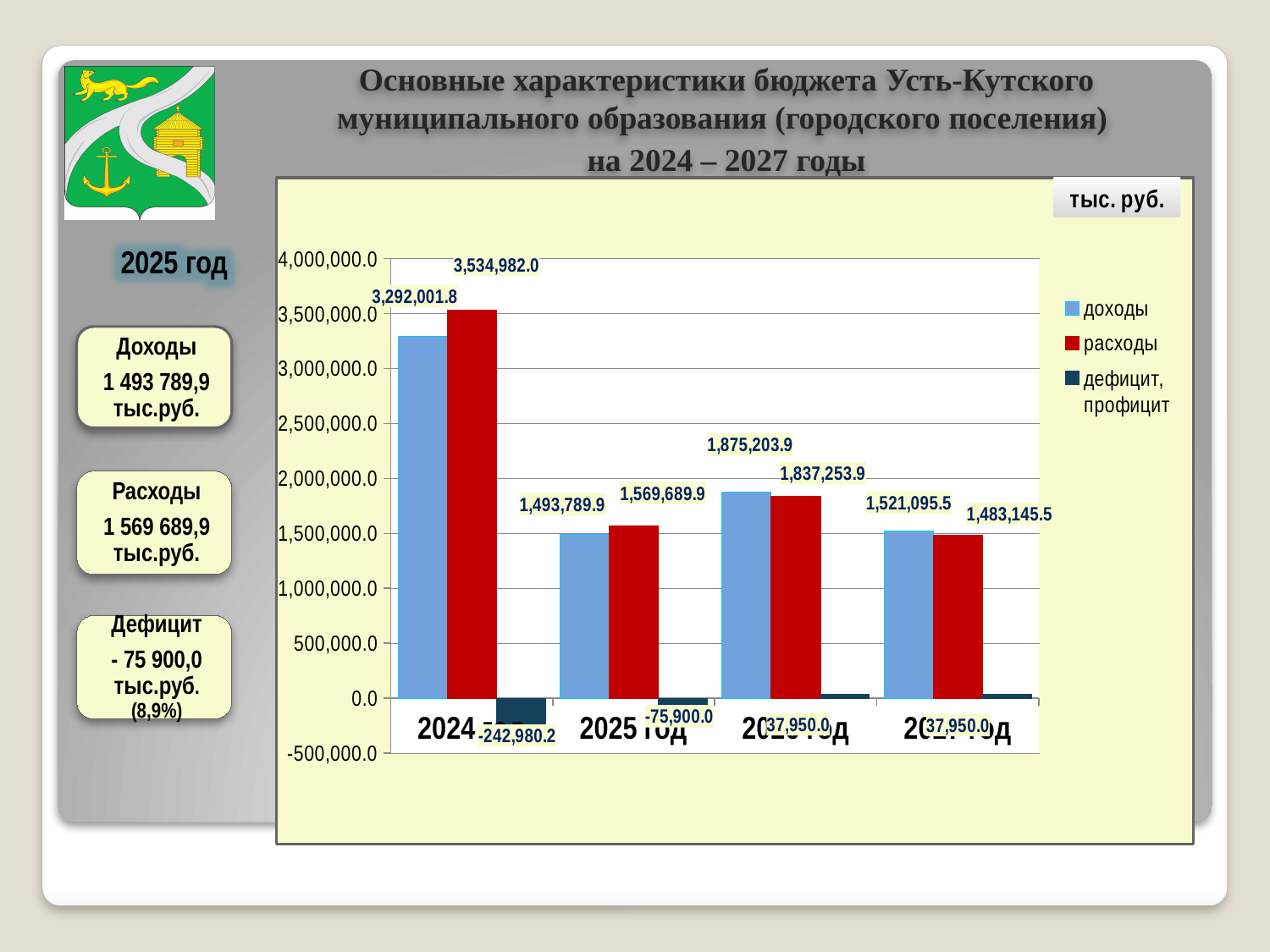
Which year has the lowest расходы? 2027 год By how much do расходы exceed доходы in 2025 год? 75,900.0 How many series does the legend list? 3 How many years are shown on the x axis? 4 In 2026 год, which is larger: доходы or расходы? доходы Which year has the highest доходы? 2024 год What is the value of расходы for 2027 год? 1,483,145.5 Is the value of доходы for 2025 год greater or less than 2,000,000.0? less What is the value of дефицит, профицит for 2024 год? -242,980.2 What is the value of расходы for 2025 год? 1,569,689.9 What kind of chart is shown on the slide? bar chart What is the value of доходы for 2024 год? 3,292,001.8